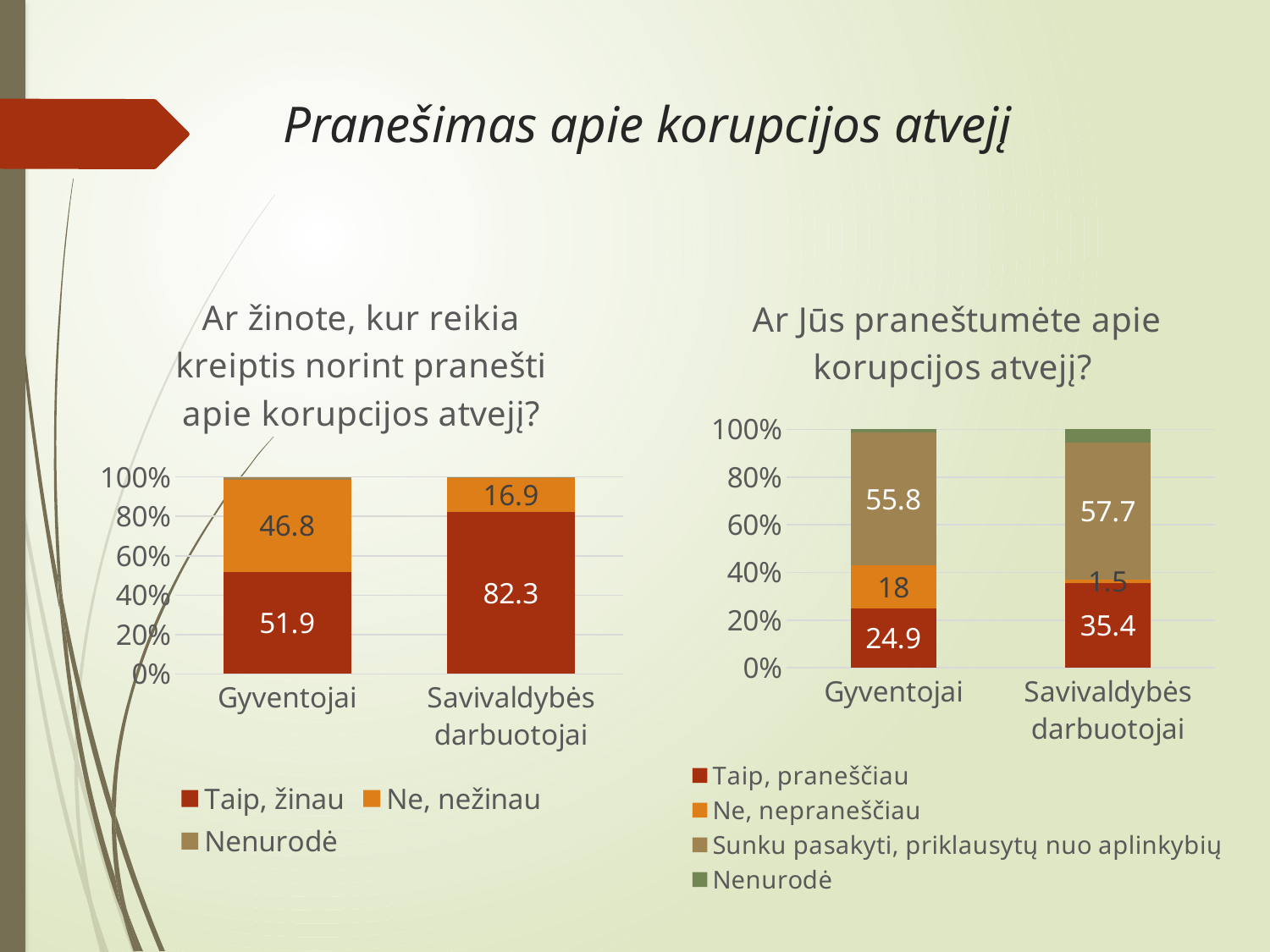
In the left chart (Ar žinote, kur reikia kreiptis...), how many series does the legend list? 3 In the left chart (Ar žinote, kur reikia kreiptis...), what is the value of "Ne, nežinau" for Savivaldybės darbuotojai? 16.9 In the right chart (Ar Jūs praneštumėte apie korupcijos atvejį?), what is the value of "Sunku pasakyti, priklausytų nuo aplinkybių" for Gyventojai? 55.8 In the right chart (Ar Jūs praneštumėte apie korupcijos atvejį?), how many series does the legend list? 4 In the left chart (Ar žinote, kur reikia kreiptis...), which category has the higher "Taip, žinau" value? Savivaldybės darbuotojai In the right chart (Ar Jūs praneštumėte apie korupcijos atvejį?), which category has the larger "Ne, nepraneščiau" value? Gyventojai In the right chart (Ar Jūs praneštumėte apie korupcijos atvejį?), what is the value of "Ne, nepraneščiau" for Savivaldybės darbuotojai? 1.5 In the right chart (Ar Jūs praneštumėte apie korupcijos atvejį?), what is the value of "Taip, praneščiau" for Gyventojai? 24.9 In the right chart (Ar Jūs praneštumėte apie korupcijos atvejį?), what is the difference between the "Taip, praneščiau" values for Savivaldybės darbuotojai and Gyventojai? 10.5 In the left chart (Ar žinote, kur reikia kreiptis...), what is the difference between the "Taip, žinau" values for Savivaldybės darbuotojai and Gyventojai? 30.4 In the left chart (Ar žinote, kur reikia kreiptis...), what is the value of "Taip, žinau" for Gyventojai? 51.9 What type of chart is the left chart (Ar žinote, kur reikia kreiptis...)? Stacked bar chart